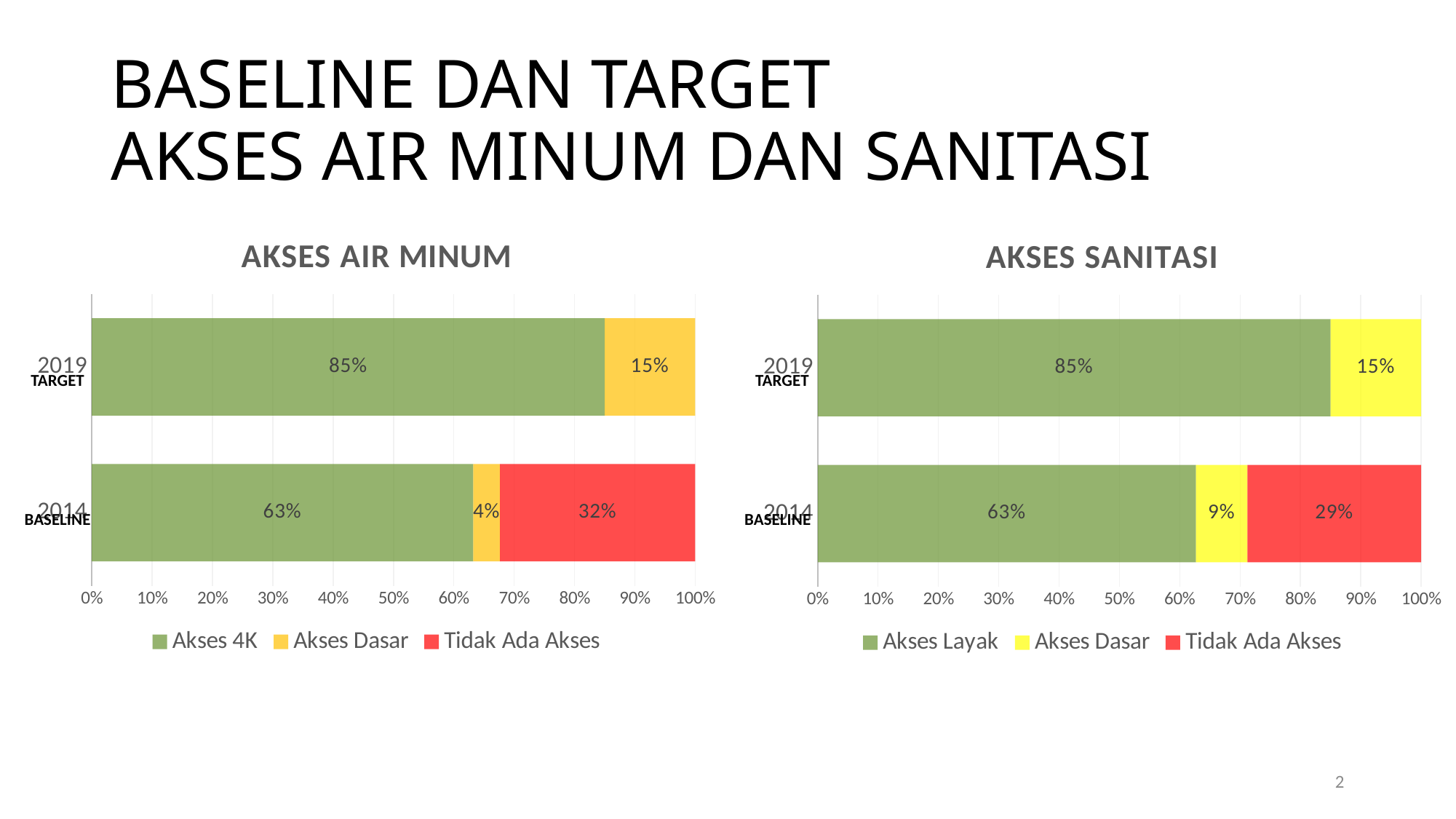
In the AKSES AIR MINUM chart, what is the value for Tidak Ada Akses in 2014? 32% In the AKSES SANITASI chart, what is the value for Akses Dasar in 2014? 9% In the AKSES AIR MINUM chart, what is the value for Akses Dasar in 2019? 15% What kind of chart is the AKSES AIR MINUM chart? Stacked bar chart In the AKSES SANITASI chart, what is the value for Akses Layak in 2019? 85% In the AKSES AIR MINUM chart, which series is shown in red? Tidak Ada Akses How many series does the legend of the AKSES SANITASI chart list? 3 In the AKSES AIR MINUM chart, what is the value for Akses 4K in 2014? 63% In the AKSES SANITASI chart, which is larger in 2014: Akses Dasar or Tidak Ada Akses? Tidak Ada Akses In the AKSES AIR MINUM chart, what is the difference between the Akses 4K value in 2019 and in 2014? 22% In the AKSES SANITASI chart, what is the value for Tidak Ada Akses in 2014? 29%